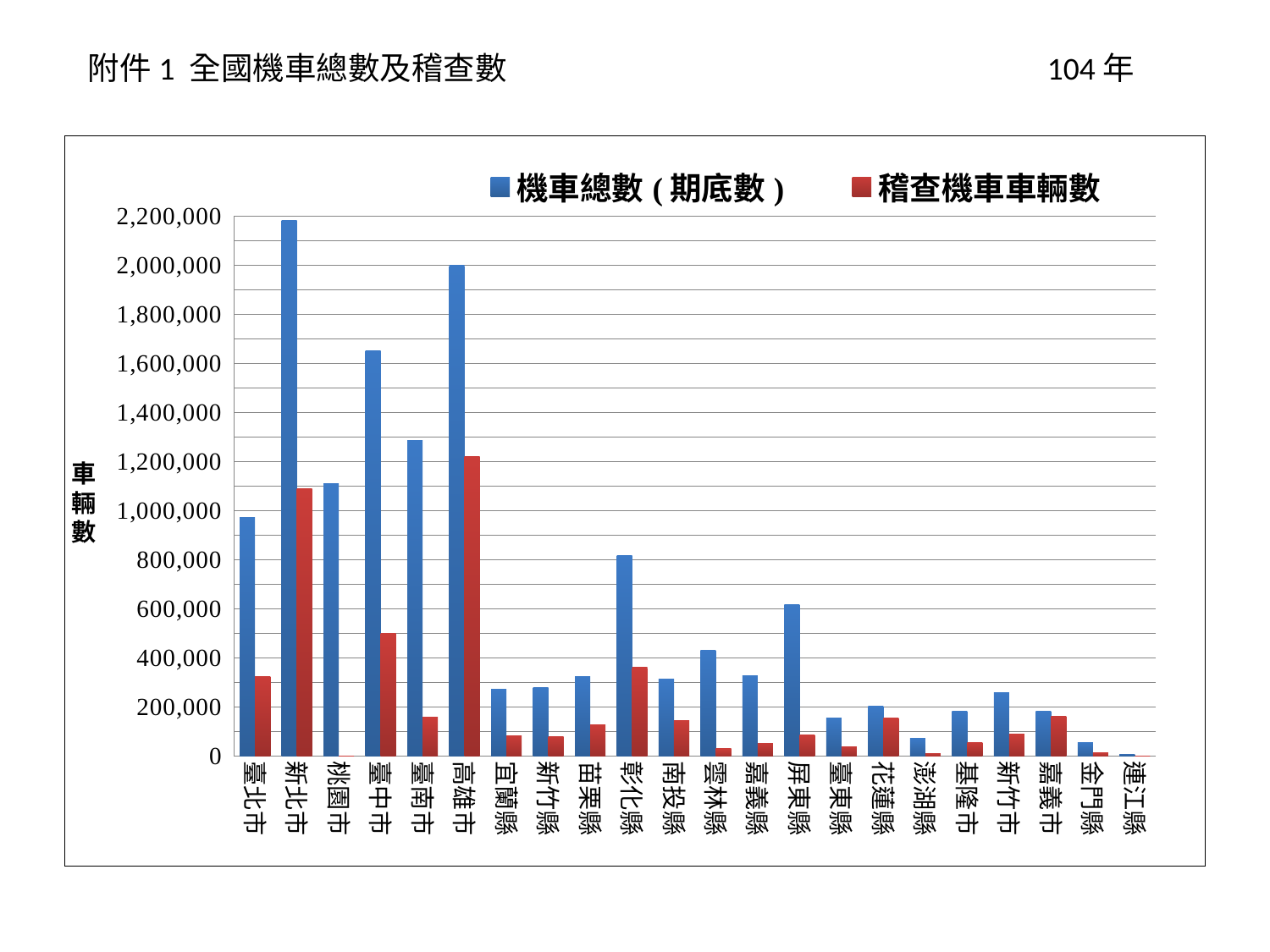
Which has a larger 機車總數(期底數), 雲林縣 or 嘉義縣? 雲林縣 What is the label on the vertical axis of the chart? 車輛數 Is the 稽查機車車輛數 for 高雄市 greater or less than 1,000,000? greater How many series does the legend list? 2 Is the 機車總數(期底數) for 彰化縣 greater or less than 600,000? greater What kind of chart is shown on the slide? bar chart Which category has the lowest 機車總數(期底數)? 連江縣 Which has a larger 機車總數(期底數), 臺中市 or 臺南市? 臺中市 Is the 機車總數(期底數) for 臺北市 greater or less than 800,000? greater Which category has the highest 稽查機車車輛數? 高雄市 How many categories (cities/counties) are shown on the x axis? 22 Which category has the highest 機車總數(期底數)? 新北市